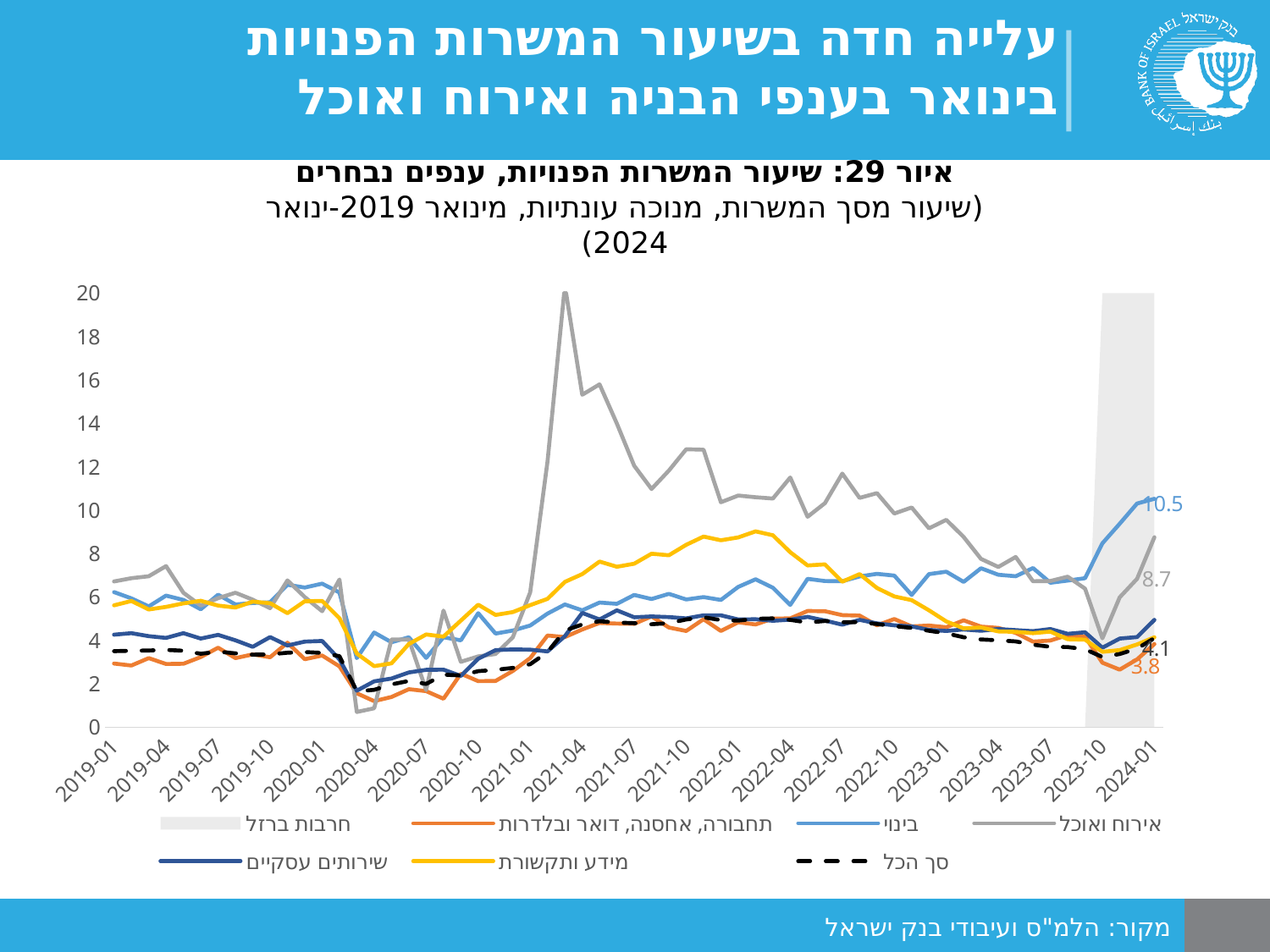
Does the בינוי series rise or fall between 2023-10 and 2024-01? rises What is the difference between the final labelled values of בינוי and אירוח ואוכל? 1.8 What is the last labelled value of the בינוי series at the right end of the chart? 10.5 What is the last labelled value of the אירוח ואוכל series at the right end of the chart? 8.7 What is the last labelled value of the תחבורה, אחסנה, דואר ובלדרות series at the right end of the chart? 3.8 At the right end of the chart, which is higher: בינוי or אירוח ואוכל? בינוי What kind of chart is shown on the slide? line chart Which series has the lowest labelled value at the right end of the chart? תחבורה, אחסנה, דואר ובלדרות Is the peak value of the אירוח ואוכל series in early 2021 greater or less than 18? greater How many entries does the legend list? 7 What is the last labelled value of the סך הכל series at the right end of the chart? 4.1 Which series has the highest value at the right end of the chart? בינוי